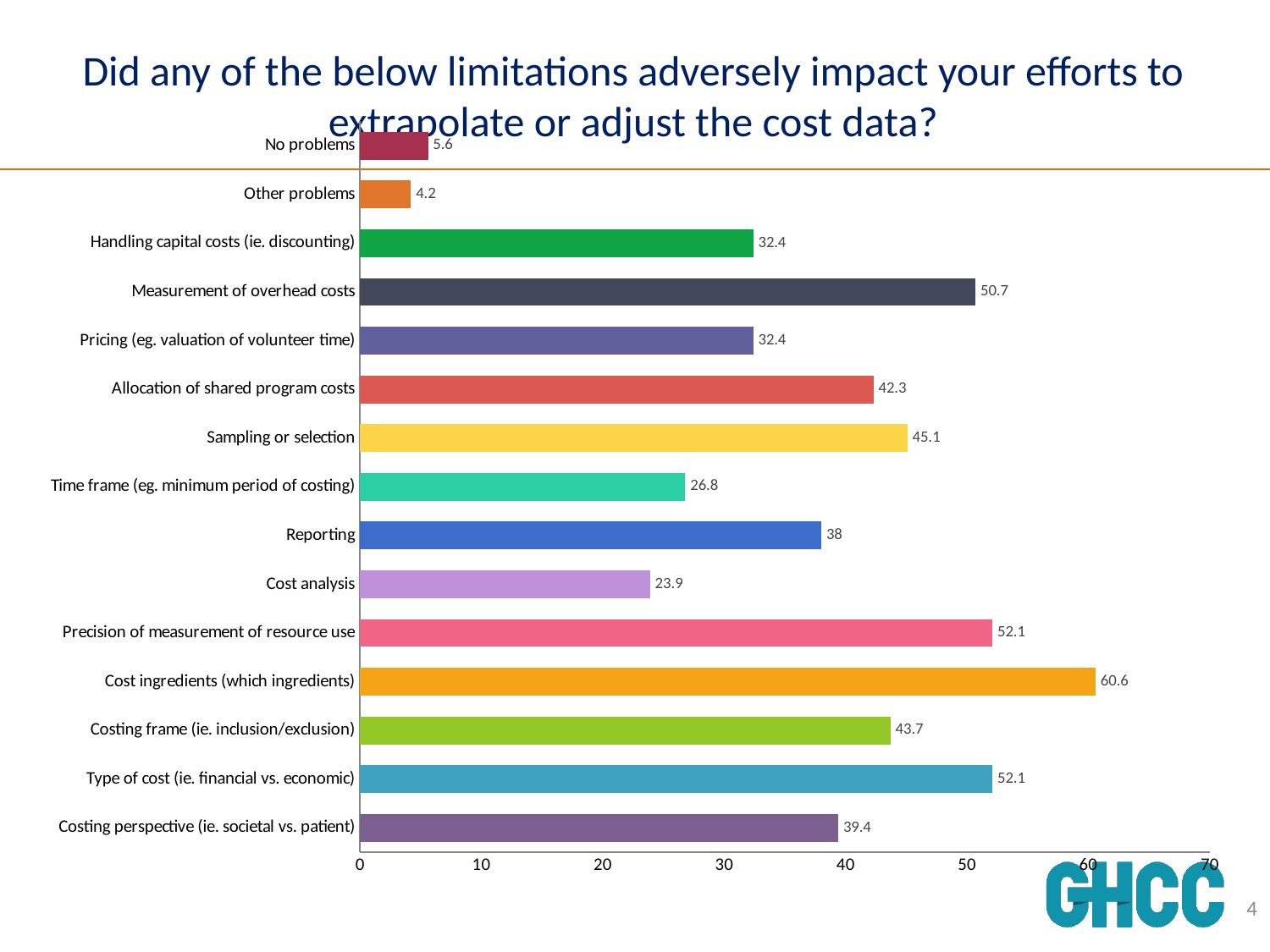
Is the value for Cost analysis greater or less than 30? less What is the difference between the values for Cost ingredients (which ingredients) and Measurement of overhead costs? 9.9 What is the value for Sampling or selection? 45.1 What is the value for Costing perspective (ie. societal vs. patient)? 39.4 What kind of chart is shown on the slide? bar chart Which category has the lowest value? Other problems How many categories are shown in the chart? 15 Which category has the highest value? Cost ingredients (which ingredients) What is the value for No problems? 5.6 What is the value for Measurement of overhead costs? 50.7 Which is larger, the value for Sampling or selection or the value for Time frame (eg. minimum period of costing)? Sampling or selection What is the difference between the values for Reporting and Cost analysis? 14.1